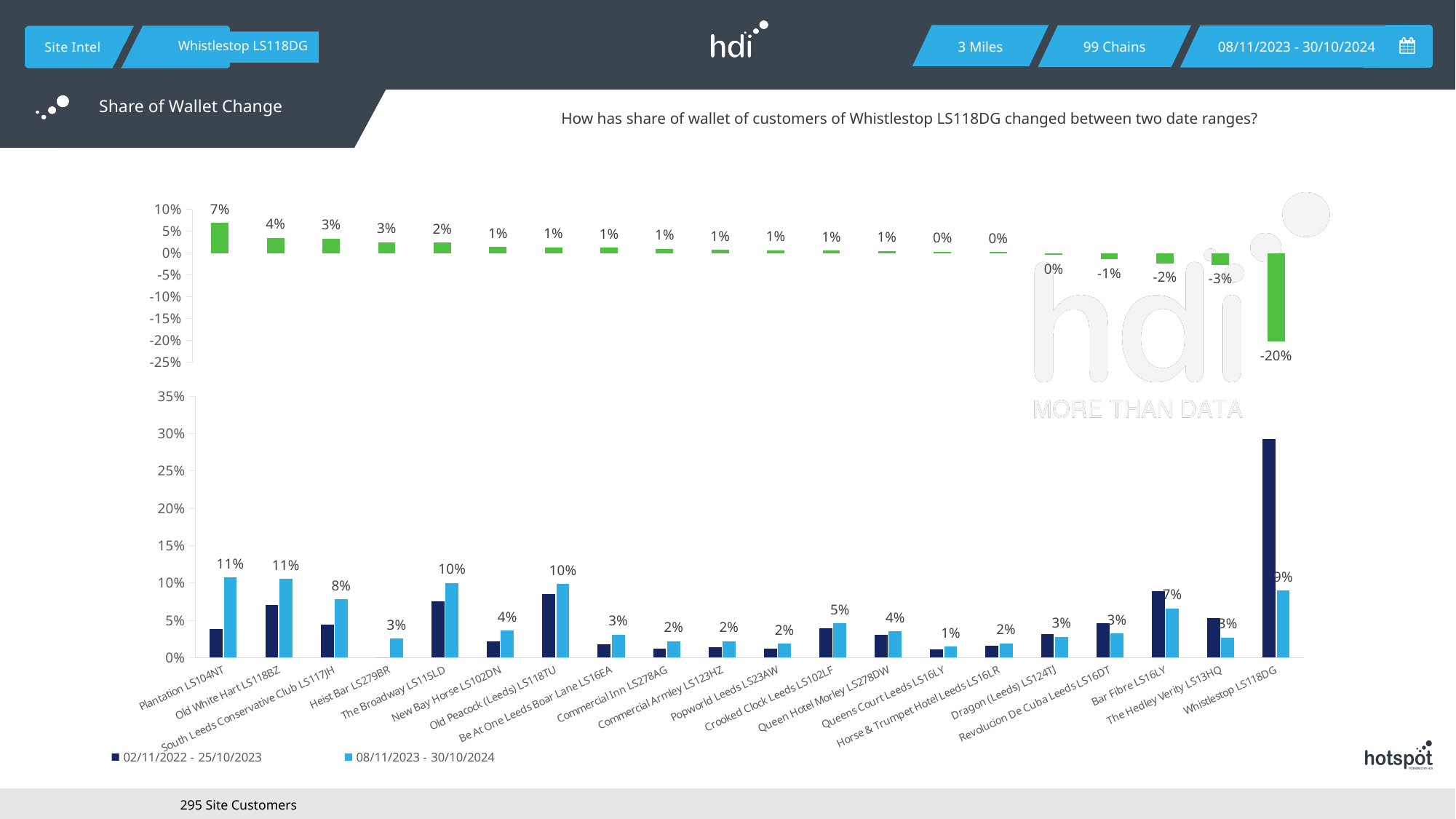
On the bottom chart, what is the share of wallet for Plantation LS104NT in the 08/11/2023 - 30/10/2024 period? 11% On the bottom chart, what is the difference between the 08/11/2023 - 30/10/2024 values for Plantation LS104NT and Heist Bar LS279BR? 8 percentage points On the bottom chart, how many series does the legend list? 2 On the bottom chart, which has the larger 08/11/2023 - 30/10/2024 value: Old Peacock (Leeds) LS118TU or New Bay Horse LS102DN? Old Peacock (Leeds) LS118TU On the bottom chart, what is the share of wallet for Bar Fibre LS16LY in the 08/11/2023 - 30/10/2024 period? 7% On the top chart, what is the lowest value shown? -20% On the bottom chart, is the 02/11/2022 - 25/10/2023 value for Whistlestop LS118DG greater or less than 25%? greater On the bottom chart, what is the share of wallet for Crooked Clock Leeds LS102LF in the 08/11/2023 - 30/10/2024 period? 5% On the bottom chart, how many venues are shown on the x axis? 20 On the bottom chart, which period has the larger value for Whistlestop LS118DG? 02/11/2022 - 25/10/2023 What kind of chart is the bottom chart? Bar chart On the top chart, what is the highest value shown? 7%